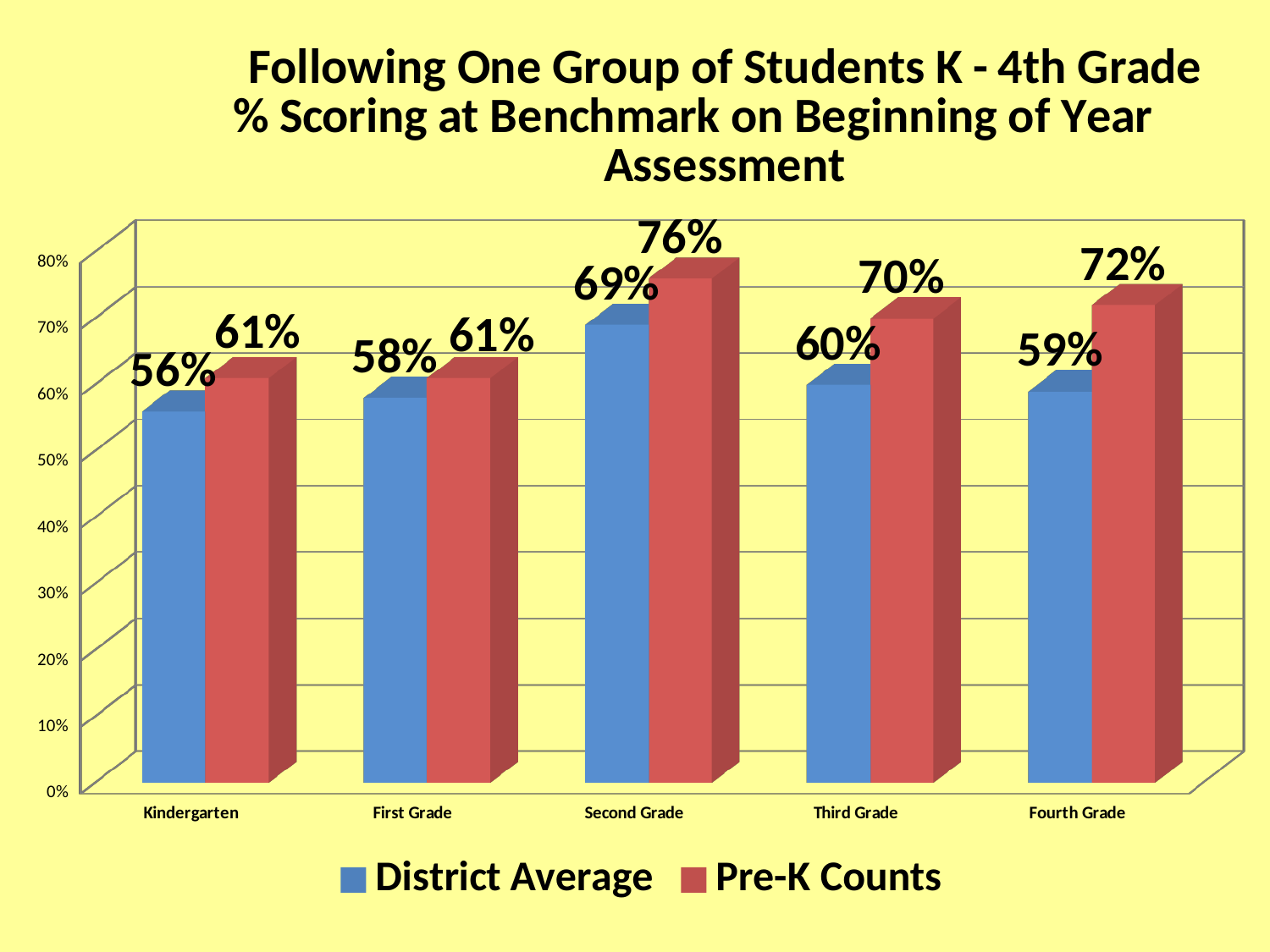
What is the difference between the Pre-K Counts values for Second Grade and Kindergarten? 15% Which grade has the lowest District Average value? Kindergarten What is the difference between the Pre-K Counts and District Average values for Third Grade? 10% Which series is shown in red? Pre-K Counts How many series does the legend list? 2 What kind of chart is shown on the slide? Bar chart What is the District Average value for Kindergarten? 56% Which grade has the highest District Average value? Second Grade Which is larger for First Grade, the District Average or Pre-K Counts value? Pre-K Counts How many grade categories are shown on the x axis? 5 What is the Pre-K Counts value for Fourth Grade? 72% What is the Pre-K Counts value for Second Grade? 76%